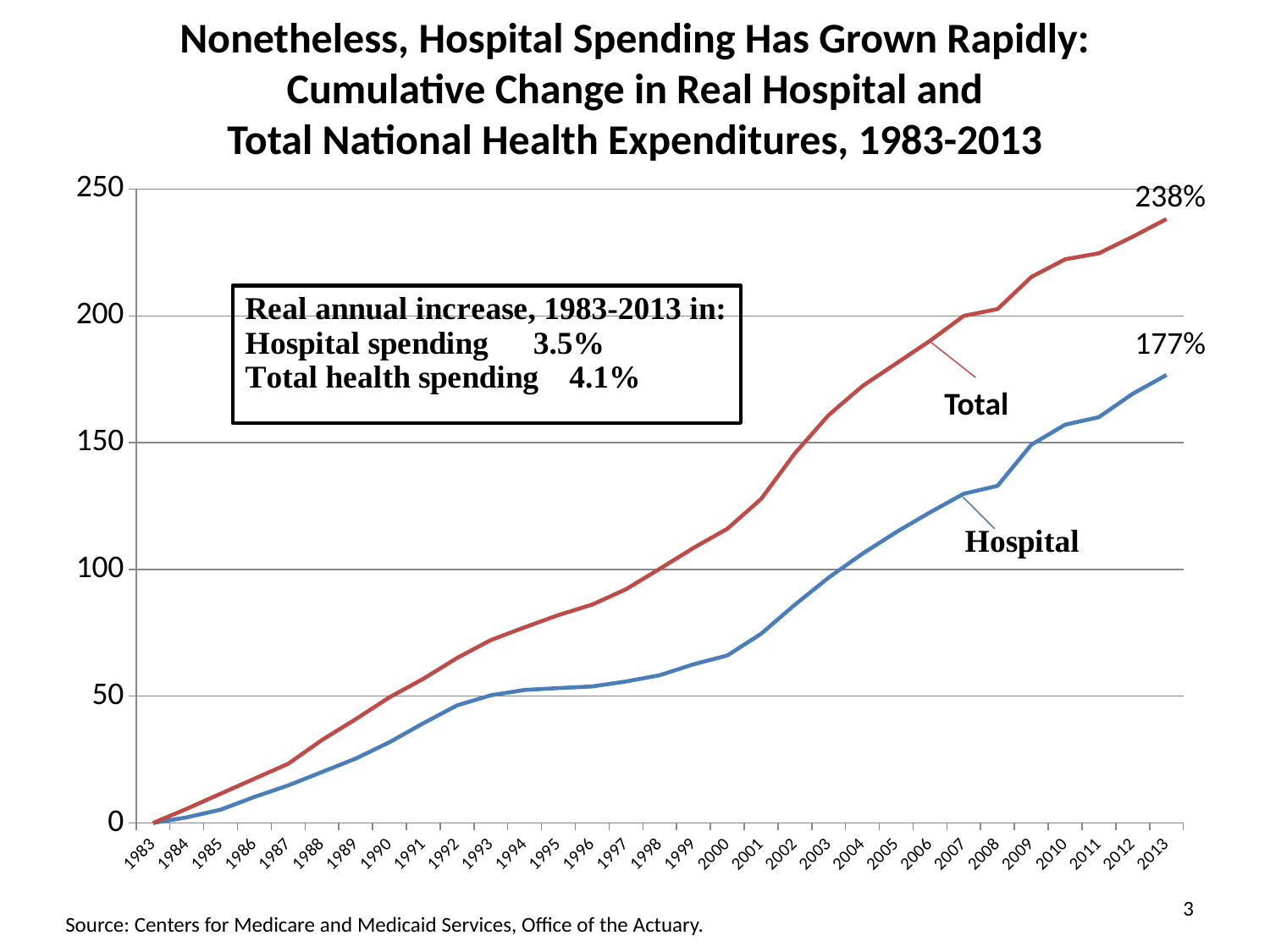
Is the value for Hospital in 2000 greater or less than 100? less Is the value for Total in 2007 greater or less than 150? greater Do the values for the Hospital series rise or fall from 1983 to 2013? Rise What kind of chart is shown on the slide? Line chart How many series are plotted on the chart? 2 In 2013, which series has the higher value, Total or Hospital? Total What is the difference between the 2013 values for Total and Hospital? 61 percentage points How many years are shown on the x axis of the chart? 31 What is the cumulative change in Total national health expenditures in 2013, as labelled on the chart? 238% What is the cumulative change in Hospital spending in 2013, as labelled on the chart? 177% What colour is the line for the Total series? Red What is the first year shown on the x axis of the chart? 1983